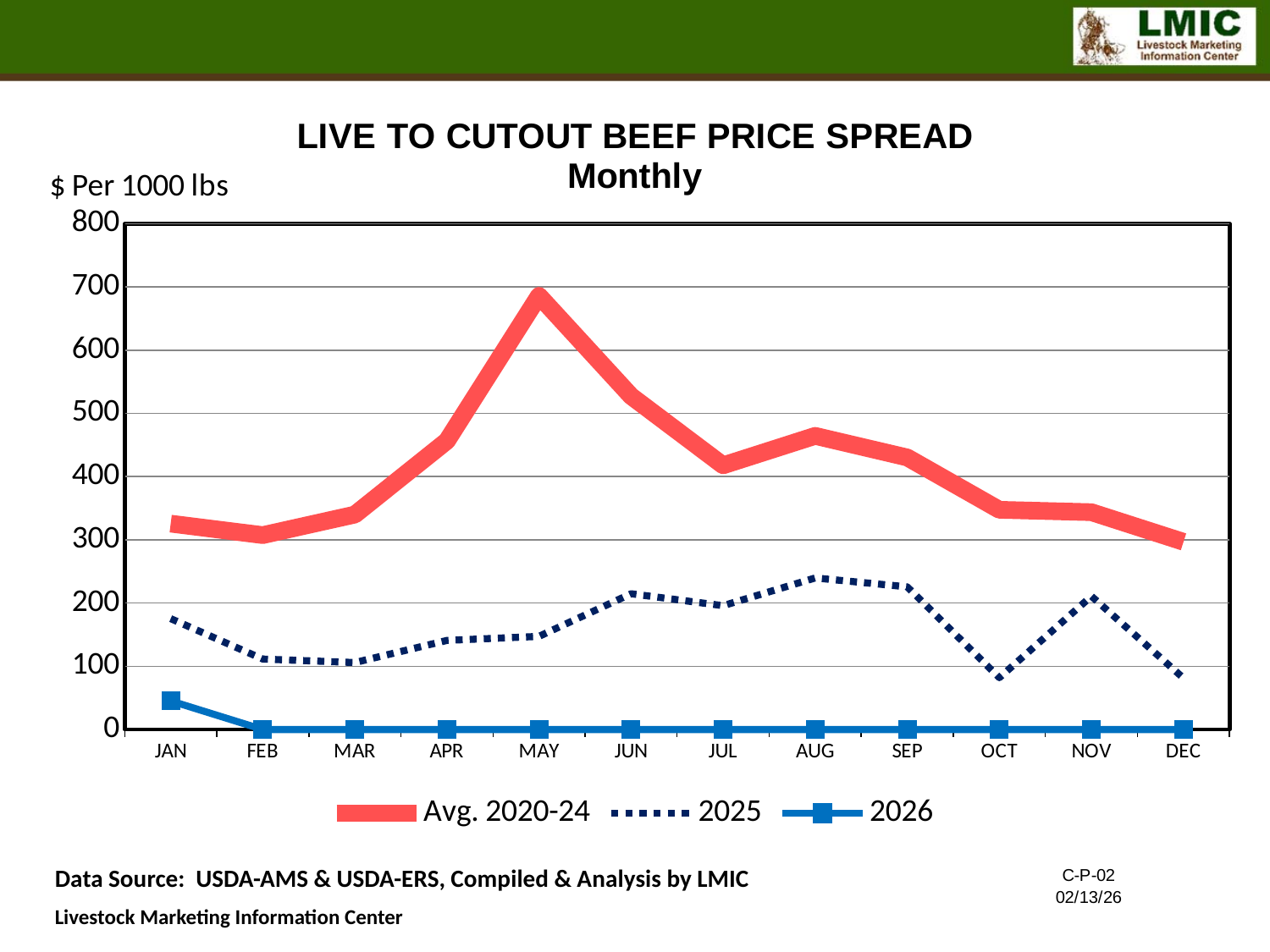
How many series does the legend list? 3 Is the 2026 value for JAN greater or less than 100? less What unit is shown on the y axis of the chart? $ Per 1000 lbs Does the Avg. 2020-24 series rise or fall from MAY to JUL? fall What kind of chart is shown on the slide? line chart In which month does the Avg. 2020-24 series reach its highest value? MAY In JAN, which series has the larger value, Avg. 2020-24 or 2025? Avg. 2020-24 How many months are shown along the x axis? 12 Does the 2025 series rise or fall from FEB to JUN? rise Is the 2025 value for OCT greater or less than 100? less In which month does the 2025 series reach its highest value? AUG Is the Avg. 2020-24 value for MAY greater or less than 600? greater